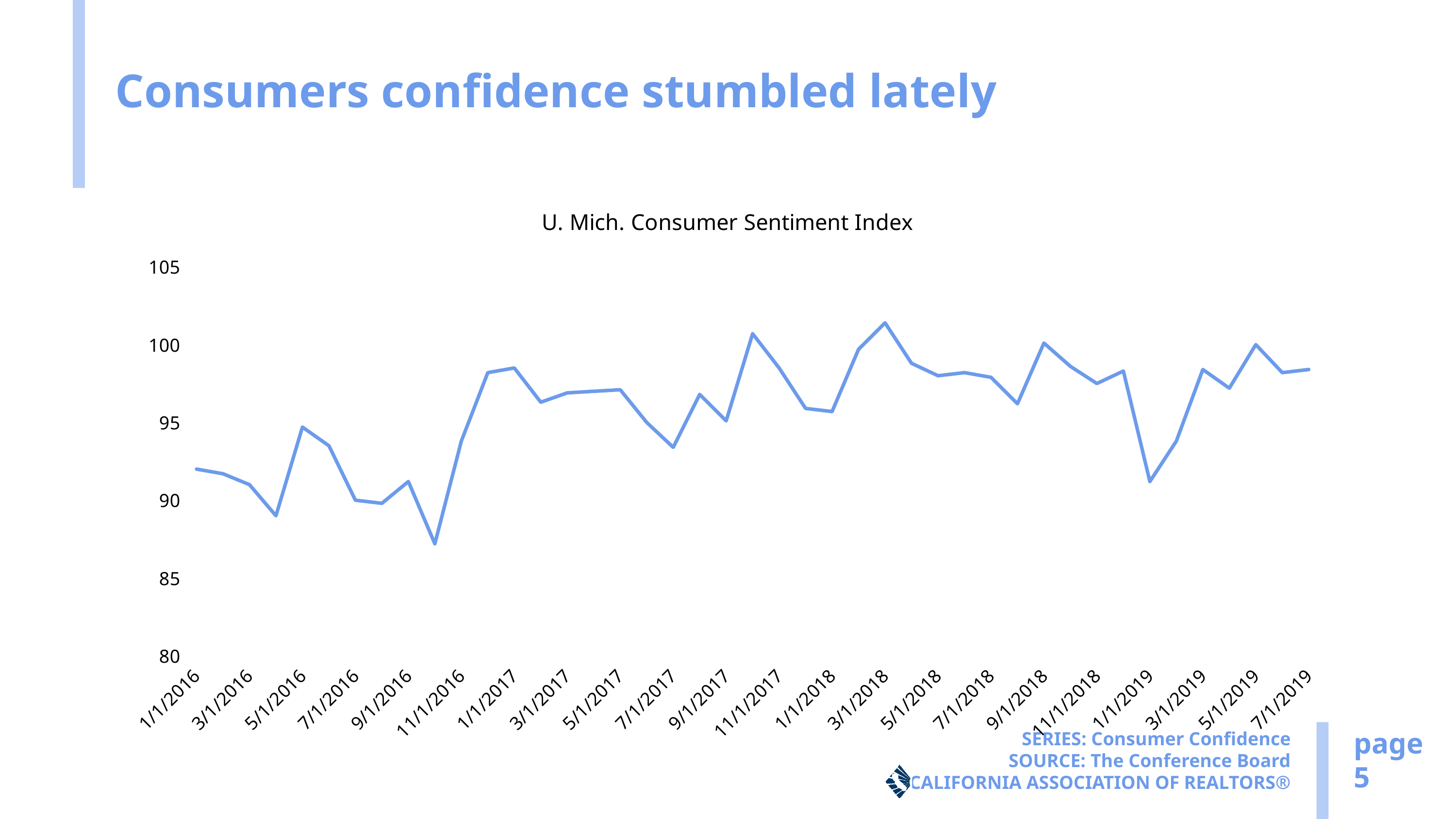
Is the value for 7/1/2017 greater or less than 95? less What is the title of the chart? U. Mich. Consumer Sentiment Index Is the value for 3/1/2018 greater or less than 100? greater Is the value for 1/1/2016 greater or less than 90? greater What kind of chart is shown on the slide? line chart Which date has the highest value on the chart? 3/1/2018 Do the values rise or fall from 3/1/2018 to 1/1/2019? fall How many dates are labeled on the x axis of the chart? 22 Which is larger, the value for 1/1/2016 or the value for 11/1/2016? 11/1/2016